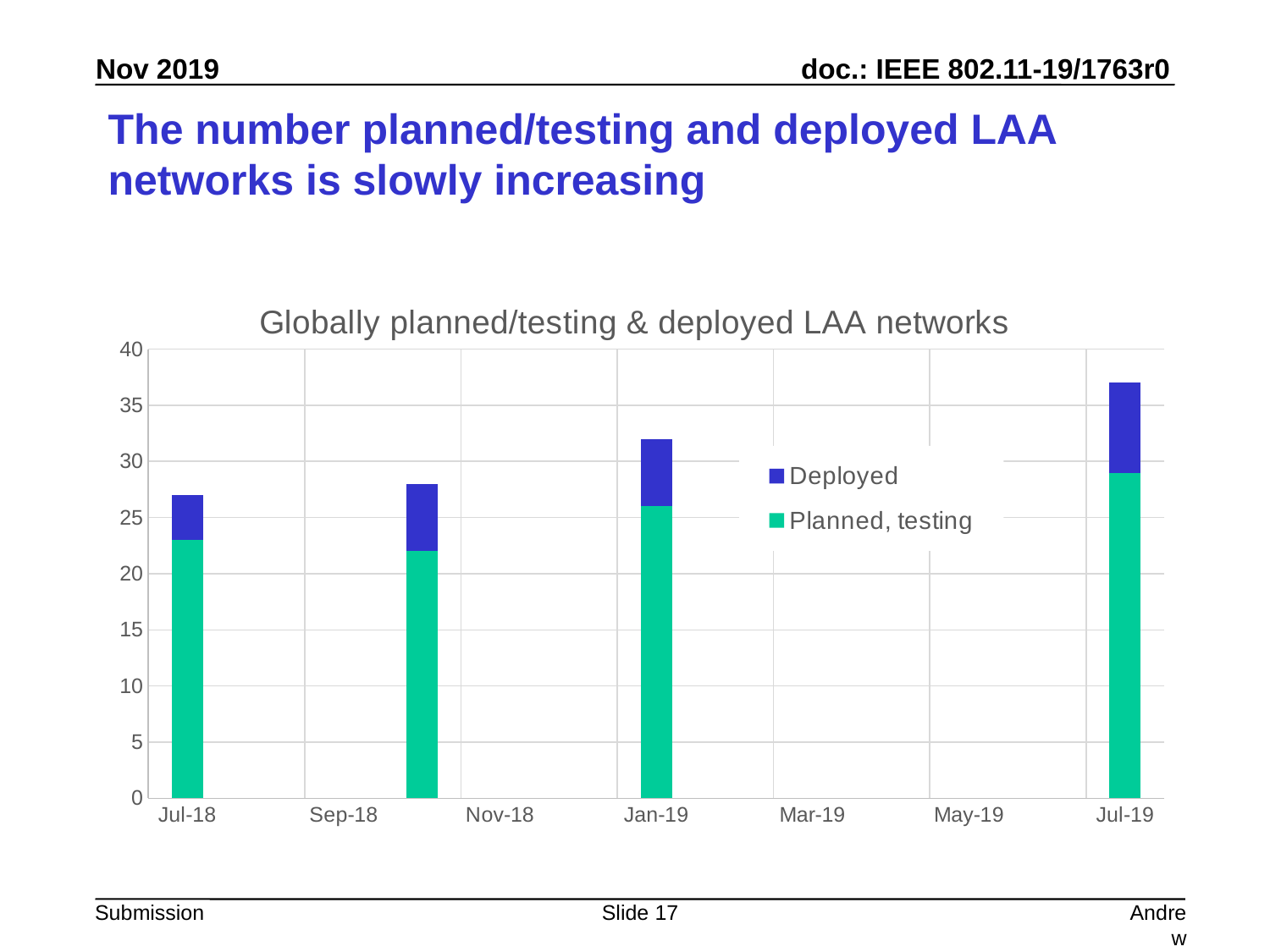
Is the Planned, testing value for Jul-19 greater or less than 25? greater How many bars are plotted in the chart? 4 Which date has the largest Planned, testing value? Jul-19 Do the total bar heights rise or fall from Jul-18 to Jul-19? rise Which date has the tallest total bar? Jul-19 Is the total value for Jul-19 greater or less than 35? greater What is the title of the chart? Globally planned/testing & deployed LAA networks Is the Planned, testing value for Jul-18 greater or less than 25? less What kind of chart is shown on the slide? Stacked bar chart How many series does the legend list? 2